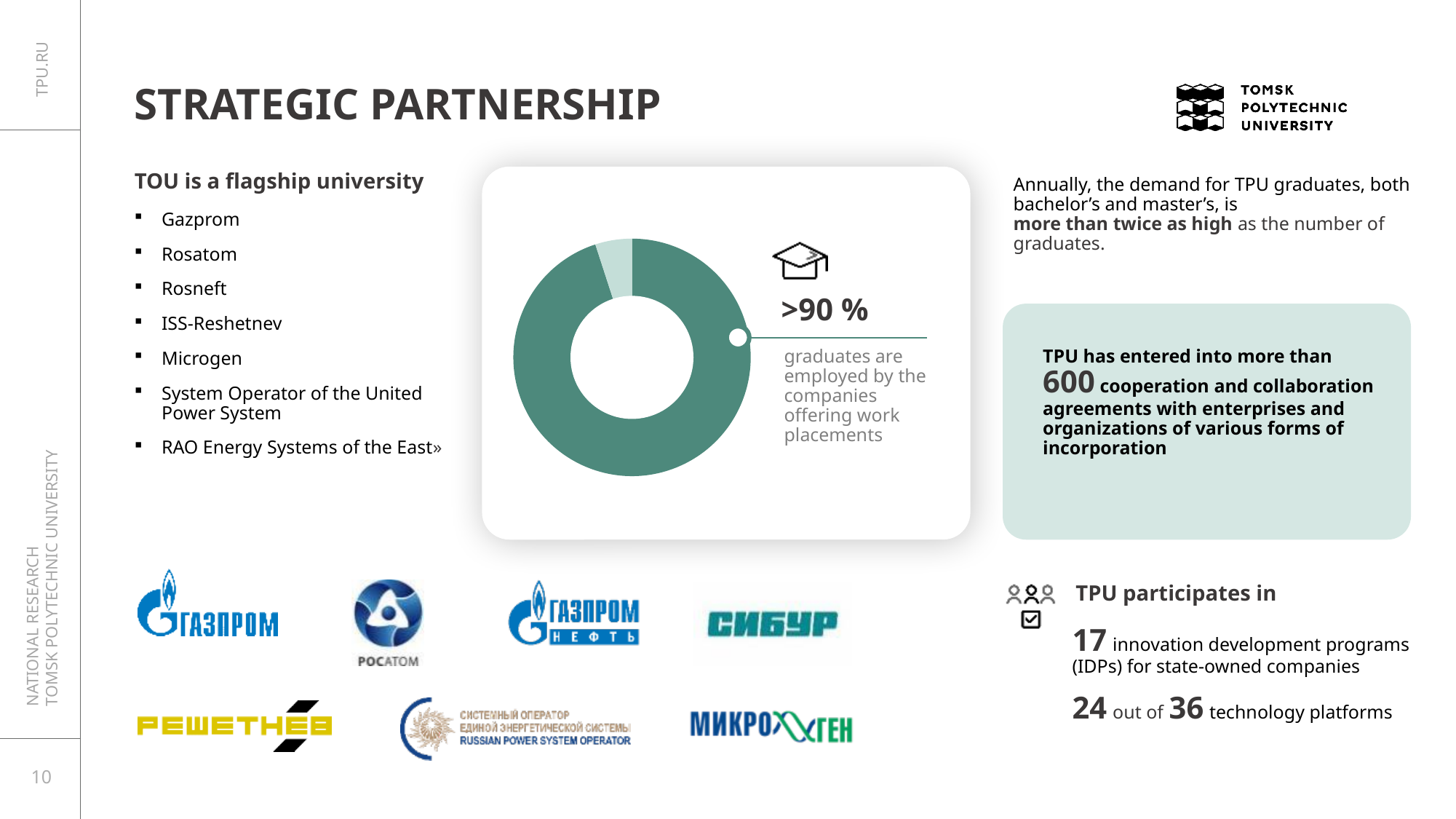
According to the donut chart, what share of graduates are employed by the companies offering work placements? >90 % What kind of chart is shown in the centre of the slide? donut chart Which slice of the donut chart is larger, the dark teal one or the light green one? the dark teal one What does the large dark teal slice of the donut chart represent? graduates employed by the companies offering work placements What value is printed next to the donut chart's callout line? >90 % What icon appears above the ">90 %" label next to the donut chart? a graduation cap How many slices does the donut chart have? 2